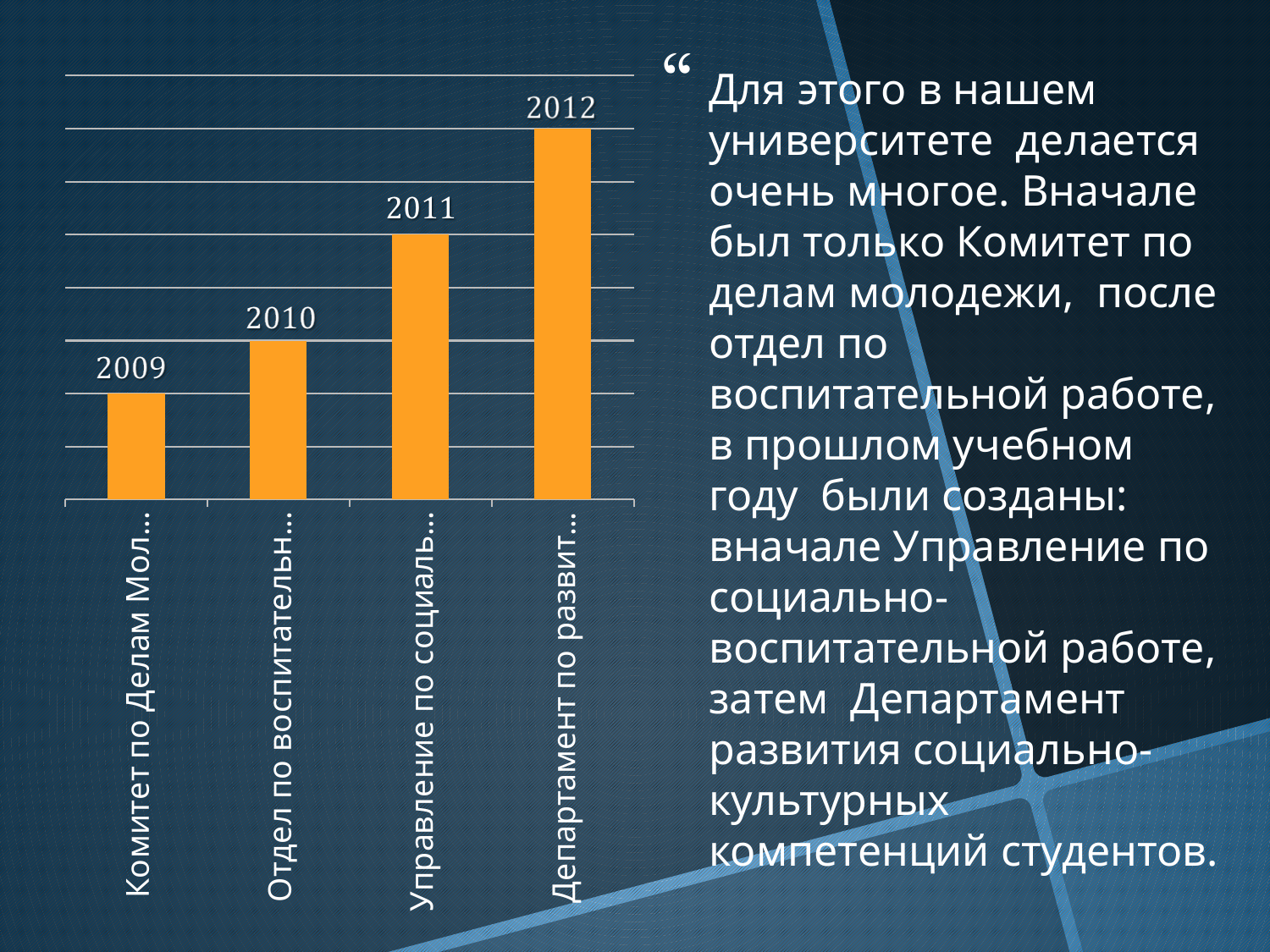
What is the difference between the data labels of the last bar (2012) and the first bar (2009)? 3 What data label is shown above the bar for Управление по социаль...? 2011 Which category has the shortest bar? Комитет по Делам Мол... Which category has the tallest bar? Департамент по развит... What data label is shown above the last bar (Департамент по развит...)? 2012 Which bar is taller: Отдел по воспитательн... or Управление по социаль...? Управление по социаль... How many bars are plotted in the chart? 4 Do the bars rise or fall from left to right along the x axis? rise What data label is shown above the bar for Отдел по воспитательн...? 2010 What type of chart is shown on the slide? bar chart What data label is shown above the first bar (Комитет по Делам Мол...)? 2009 What colour are the bars in the chart? orange